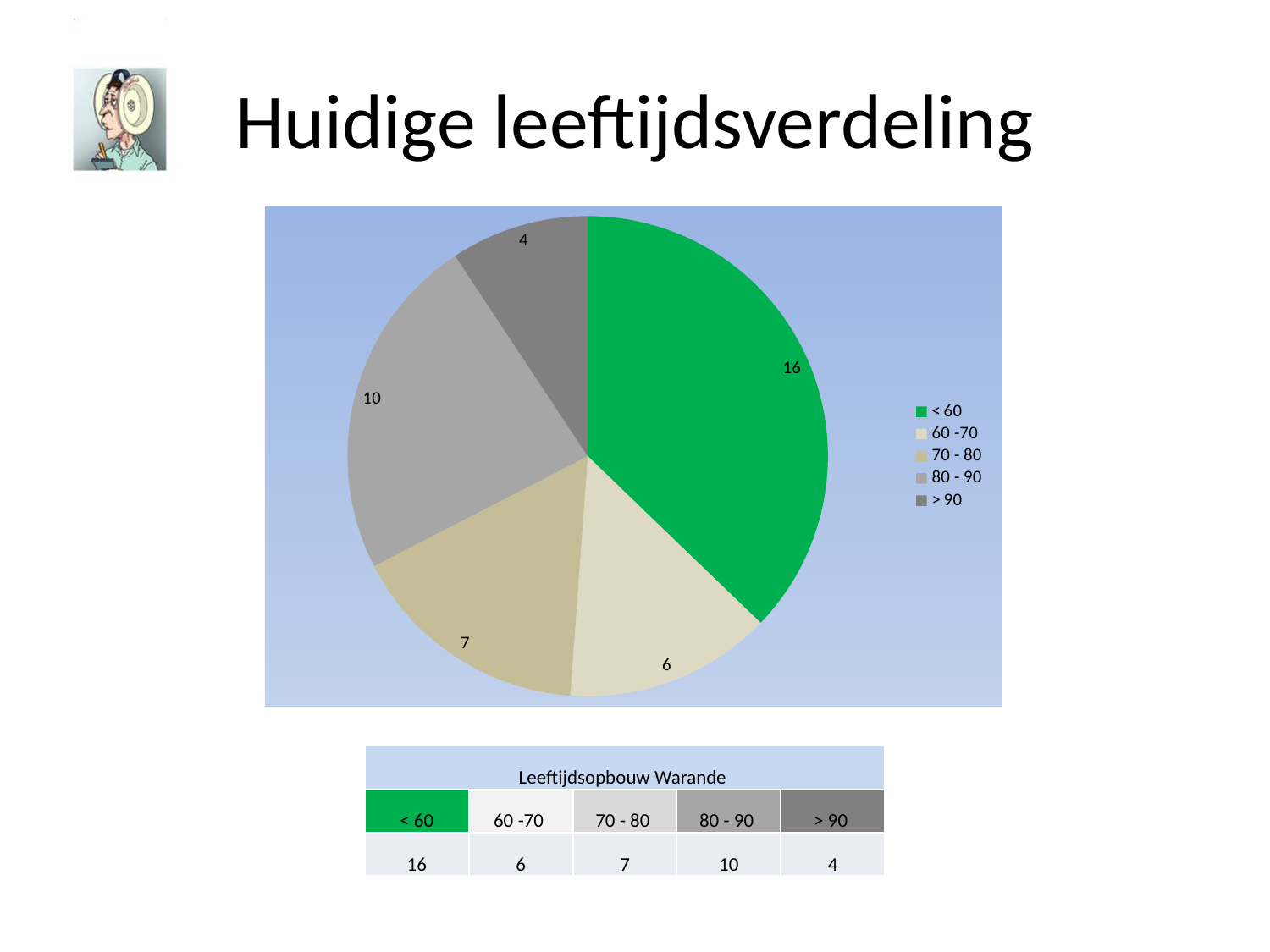
Which age group has the largest slice in the pie chart? < 60 What is the difference between the < 60 value and the 80 - 90 value in the pie chart? 6 What is the value for the 60 -70 slice of the pie chart? 6 Which age group has the smallest slice in the pie chart? > 90 How many slices does the pie chart have? 5 What is the value for the 80 - 90 slice of the pie chart? 10 Which is larger in the pie chart, the 70 - 80 slice or the 60 -70 slice? 70 - 80 What is the value for the < 60 slice of the pie chart? 16 What colour is the < 60 slice in the pie chart? green How many entries does the legend of the pie chart list? 5 What kind of chart is shown on the slide? pie chart What is the value for the > 90 slice of the pie chart? 4